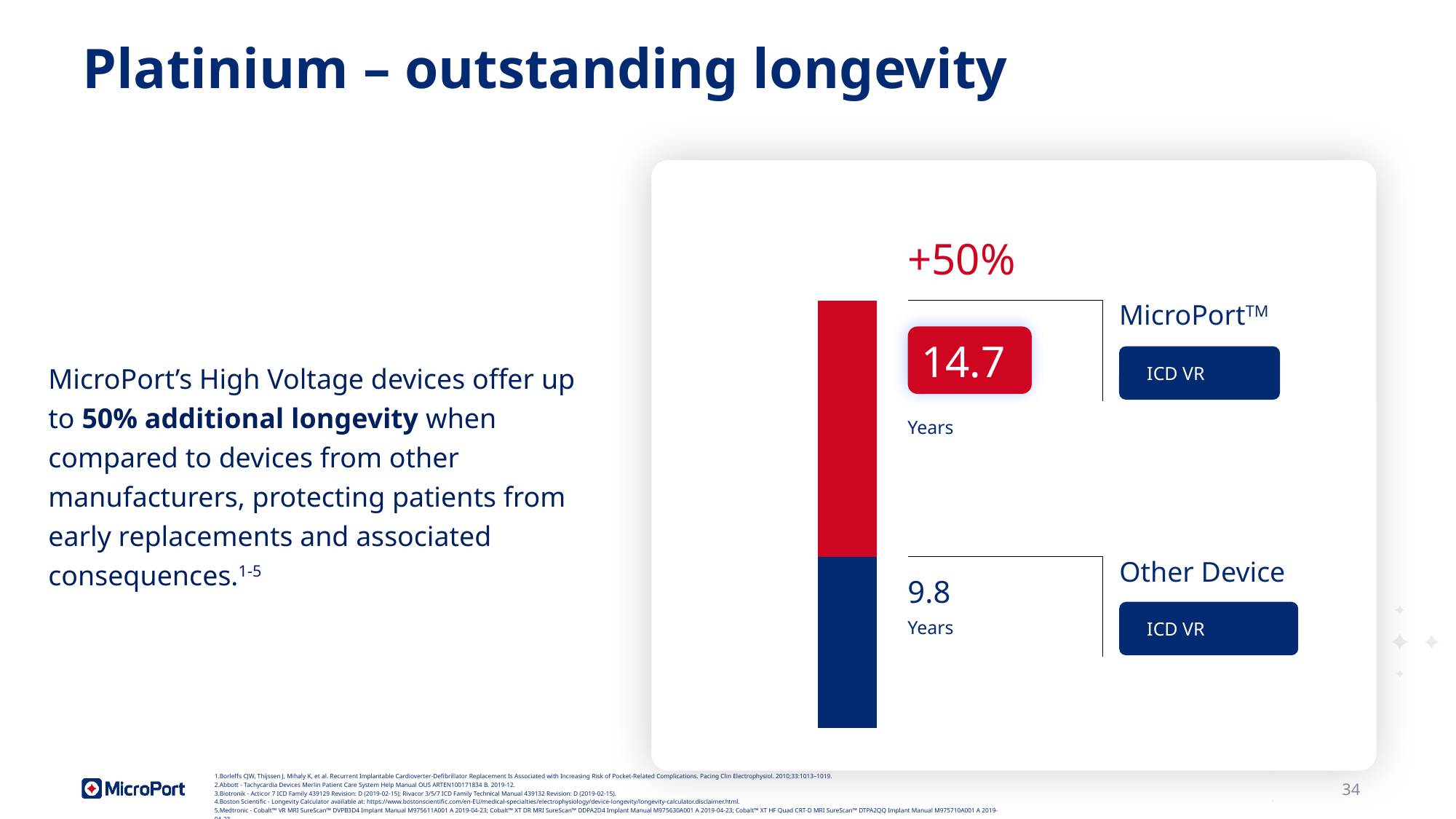
What colour is the segment representing the MicroPort ICD VR? Red How many devices are compared on the chart? 2 Which device has the highest longevity shown on the chart? MicroPort ICD VR What percentage increase is labelled above the chart? +50% Which device has the higher longevity, MicroPort ICD VR or Other Device ICD VR? MicroPort ICD VR What kind of chart is shown on the slide? Bar chart What longevity value is shown for the Other Device ICD VR? 9.8 Years Which device has the lowest longevity shown on the chart? Other Device ICD VR What is the difference in years between the MicroPort ICD VR and the Other Device ICD VR longevity? 4.9 Years What colour is the segment representing the Other Device ICD VR? Dark blue What longevity value is shown for the MicroPort ICD VR? 14.7 Years What unit are the chart values expressed in? Years